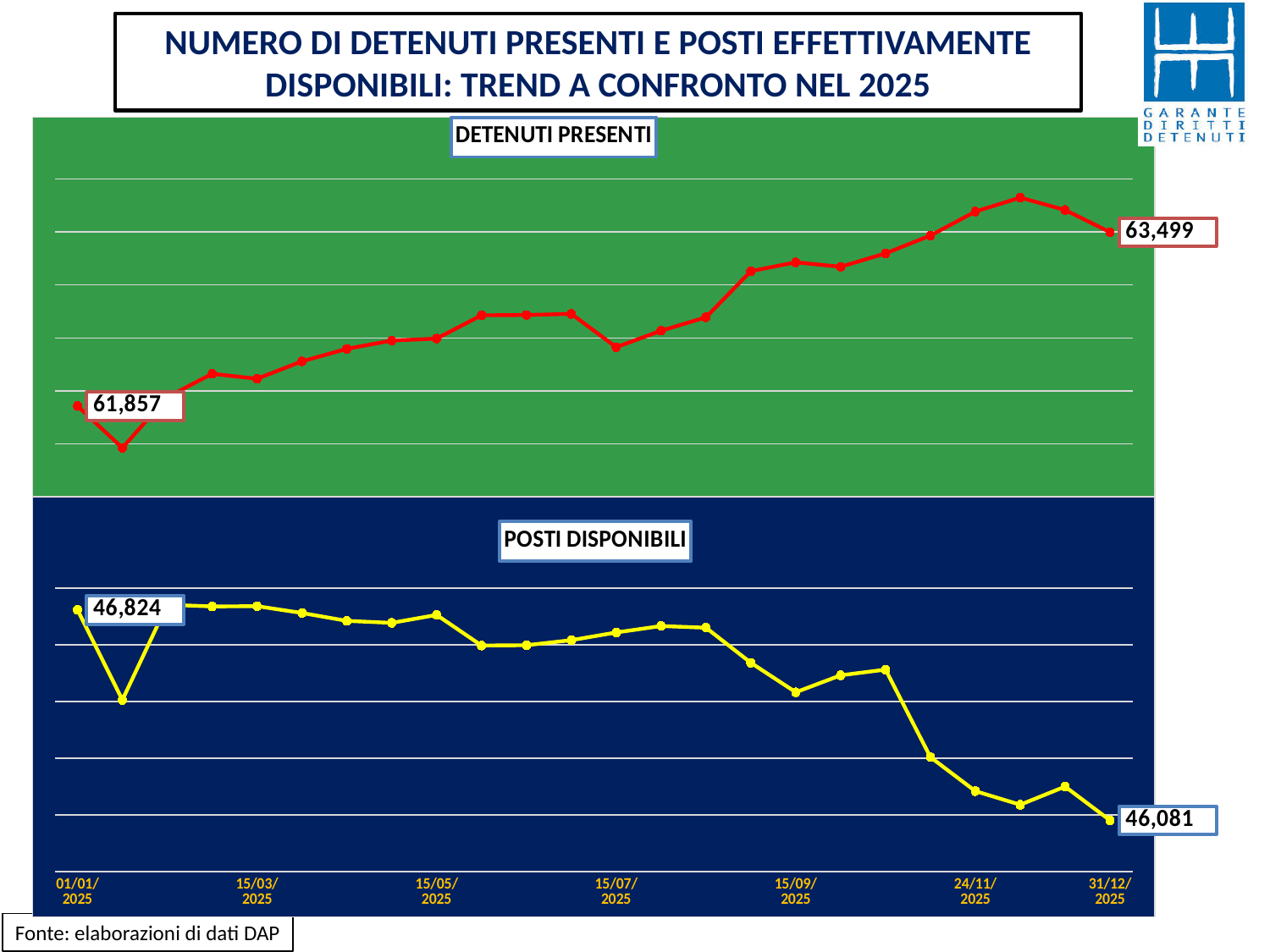
In the POSTI DISPONIBILI chart, what is the value labelled at the last point (31/12/2025)? 46,081 In the POSTI DISPONIBILI chart, do the values generally rise or fall from 01/01/2025 to 31/12/2025? fall In the POSTI DISPONIBILI chart, what is the value labelled at the first point (01/01/2025)? 46,824 How many date labels are shown on the x axis of the charts? 7 In the DETENUTI PRESENTI chart, what is the value labelled at the first point (01/01/2025)? 61,857 In the DETENUTI PRESENTI chart, what is the difference between the last labelled value (63,499) and the first labelled value (61,857)? 1,642 In the DETENUTI PRESENTI chart, do the values generally rise or fall from 01/01/2025 to 31/12/2025? rise In the DETENUTI PRESENTI chart, which is larger: the value on 01/01/2025 or the value on 31/12/2025? 31/12/2025 In the POSTI DISPONIBILI chart, which is larger: the value on 01/01/2025 or the value on 31/12/2025? 01/01/2025 In the POSTI DISPONIBILI chart, what is the difference between the first labelled value (46,824) and the last labelled value (46,081)? 743 In the DETENUTI PRESENTI chart, what is the value labelled at the last point (31/12/2025)? 63,499 What kind of chart is the DETENUTI PRESENTI chart? line chart